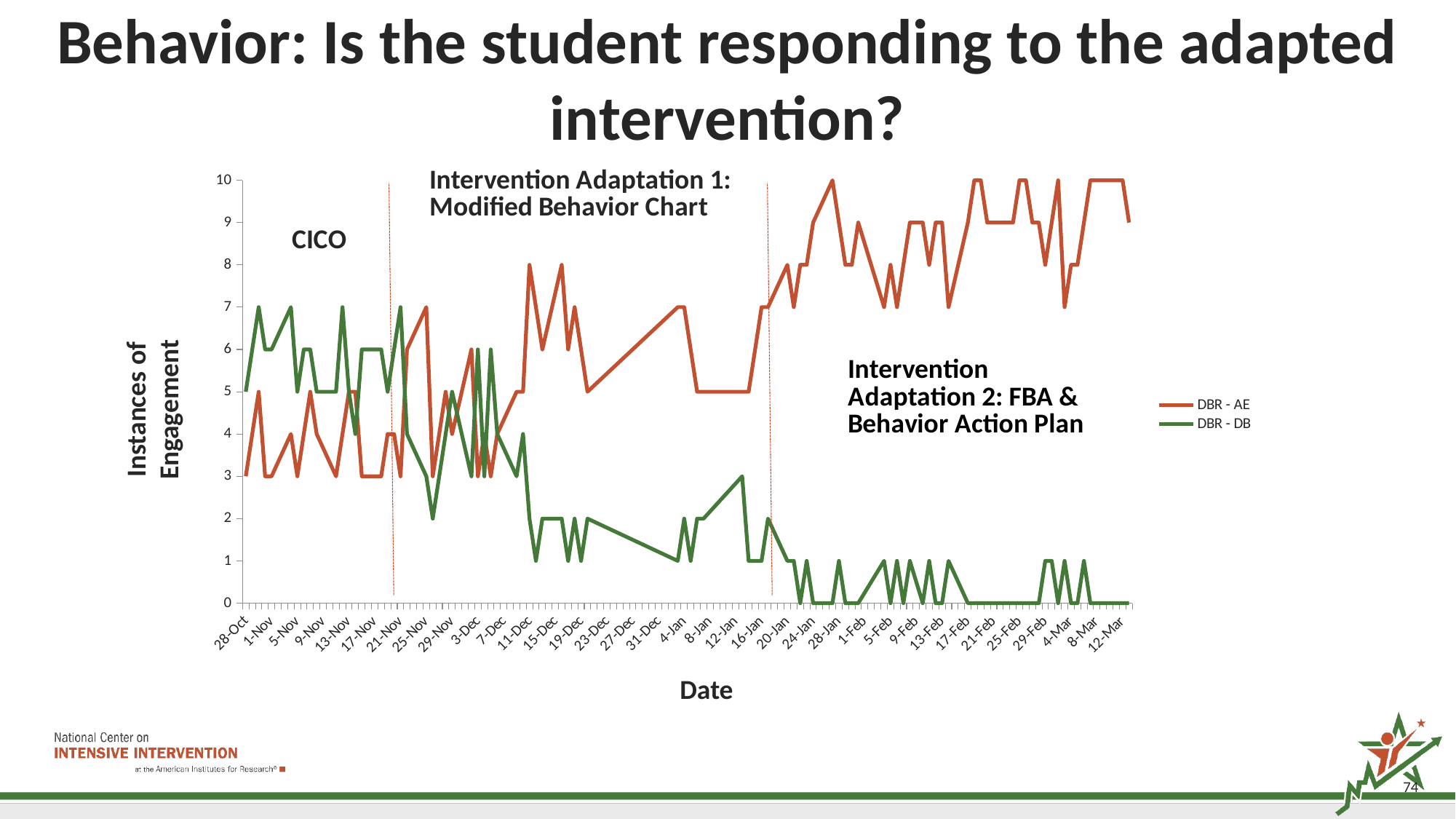
On 28-Oct, which series has the higher value, DBR - AE or DBR - DB? DBR - DB Does the DBR - AE series generally rise or fall from 28-Oct to 12-Mar? rise On 12-Mar, which series has the higher value, DBR - AE or DBR - DB? DBR - AE What kind of chart is shown on the slide? line chart What are the two series named in the legend? DBR - AE and DBR - DB What is the lowest value reached by the DBR - DB series? 0 What is the title of the vertical axis? Instances of Engagement How many series does the legend list? 2 Is the value for DBR - AE on 28-Oct greater or less than 5? less Is the value for DBR - AE on 12-Mar greater or less than 5? greater Does the DBR - DB series generally rise or fall from 28-Oct to 12-Mar? fall What is the highest value reached by the DBR - AE series? 10